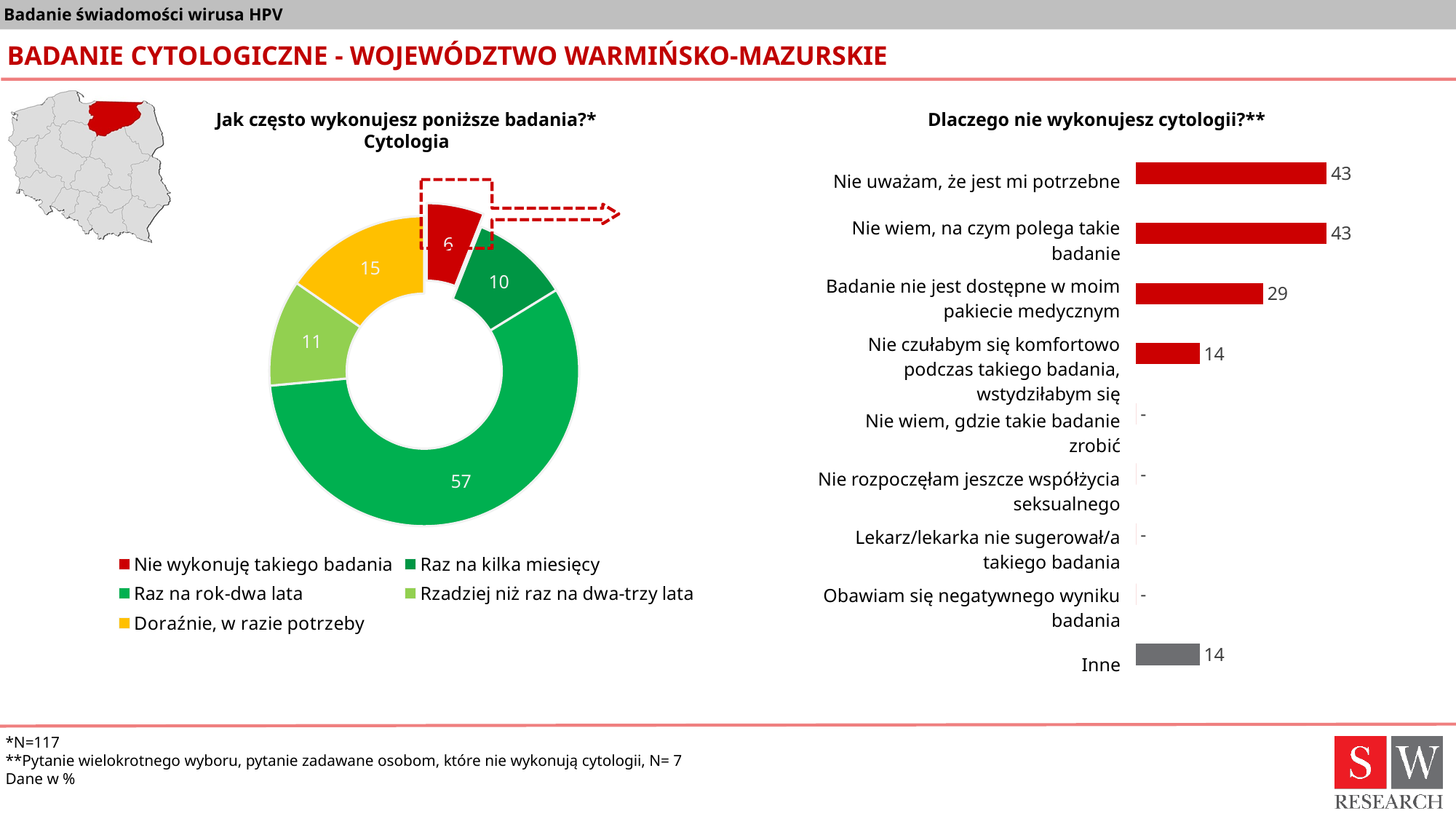
In the chart 'Jak często wykonujesz poniższe badania? Cytologia', what is the difference between 'Doraźnie, w razie potrzeby' and 'Rzadziej niż raz na dwa-trzy lata'? 4 In the chart 'Jak często wykonujesz poniższe badania? Cytologia', what is the value for 'Nie wykonuję takiego badania'? 6 In the chart 'Dlaczego nie wykonujesz cytologii?', what is the value for 'Nie uważam, że jest mi potrzebne'? 43 What kind of chart is 'Dlaczego nie wykonujesz cytologii?'? Bar chart In the chart 'Dlaczego nie wykonujesz cytologii?', what is the value for 'Inne'? 14 What kind of chart is 'Jak często wykonujesz poniższe badania? Cytologia'? Doughnut (pie) chart In the chart 'Jak często wykonujesz poniższe badania? Cytologia', which category has the smallest share? Nie wykonuję takiego badania In the chart 'Jak często wykonujesz poniższe badania? Cytologia', which category has the largest share? Raz na rok-dwa lata In the chart 'Dlaczego nie wykonujesz cytologii?', which is larger: 'Badanie nie jest dostępne w moim pakiecie medycznym' or 'Nie czułabym się komfortowo podczas takiego badania, wstydziłabym się'? Badanie nie jest dostępne w moim pakiecie medycznym In the chart 'Dlaczego nie wykonujesz cytologii?', what is the value for 'Badanie nie jest dostępne w moim pakiecie medycznym'? 29 In the chart 'Jak często wykonujesz poniższe badania? Cytologia', how many categories does the legend list? 5 In the chart 'Jak często wykonujesz poniższe badania? Cytologia', what is the value for 'Raz na rok-dwa lata'? 57